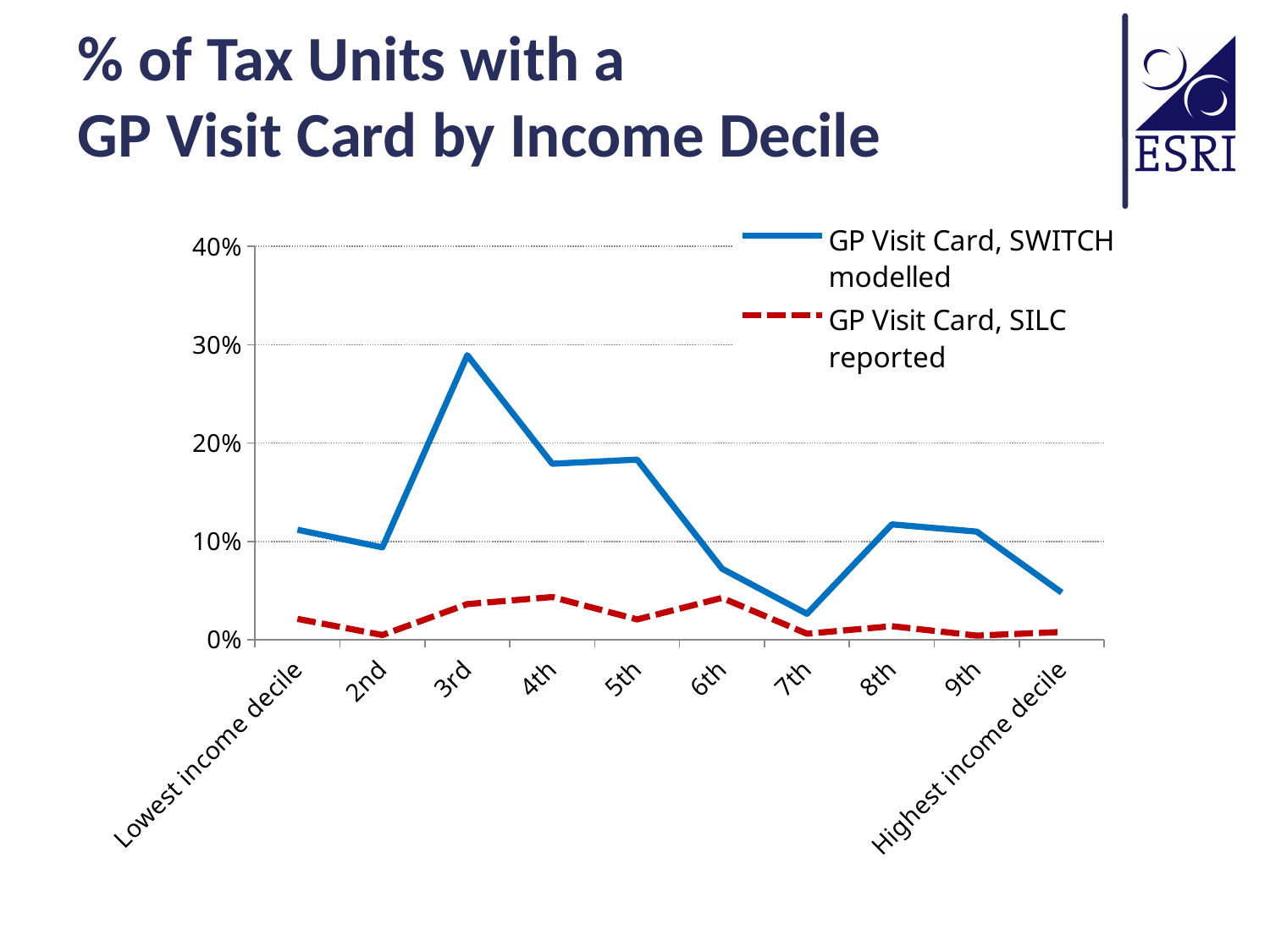
For which income decile is the GP Visit Card, SWITCH modelled value highest? 3rd Which decile has the larger GP Visit Card, SWITCH modelled value: the 6th or the 8th? 8th Does the GP Visit Card, SWITCH modelled line rise or fall from the 8th decile to the highest income decile? fall Is the GP Visit Card, SILC reported value for the 4th decile greater or less than 10%? less Is the GP Visit Card, SWITCH modelled value for the 7th decile greater or less than 10%? less What kind of chart is shown on the slide? line chart How many series does the legend list? 2 For which income decile is the GP Visit Card, SWITCH modelled value lowest? 7th How many income deciles are plotted along the x axis? 10 Which series is drawn with a dashed red line? GP Visit Card, SILC reported Is the GP Visit Card, SWITCH modelled value for the 3rd decile greater or less than 20%? greater Which is larger for the 3rd decile: the GP Visit Card, SWITCH modelled value or the GP Visit Card, SILC reported value? GP Visit Card, SWITCH modelled